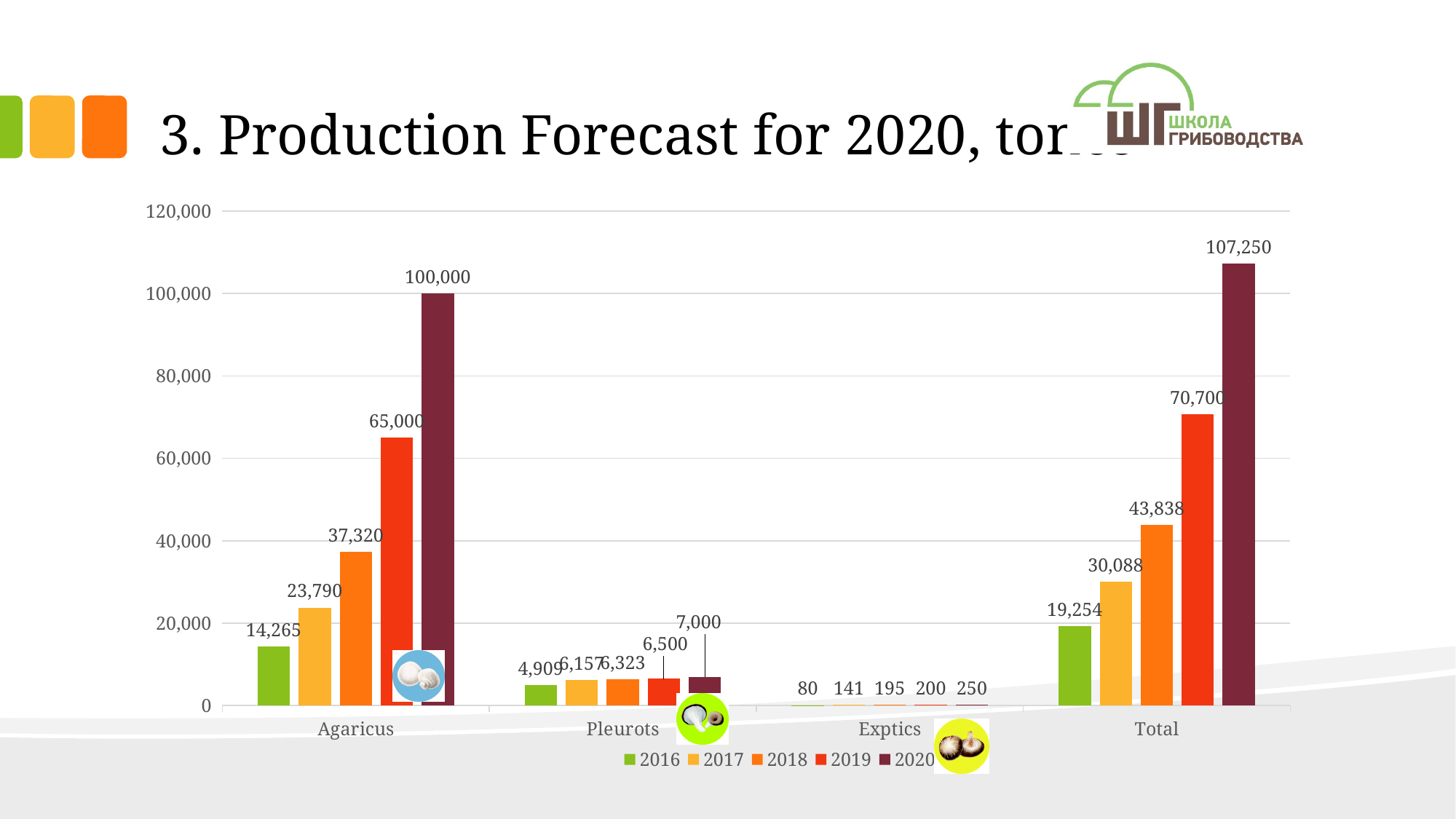
Which category has the highest value in 2018? Total What is the value for Pleurots in 2020? 7,000 Which is larger: the Total value for 2017 or the Agaricus value for 2018? Agaricus value for 2018 What is the difference between the Agaricus values for 2020 and 2019? 35,000 What is the value for Exptics in 2017? 141 What is the Total value for 2019? 70,700 Do the Total values rise or fall from 2016 to 2020? rise Which category has the lowest value in 2016? Exptics What is the value for Agaricus in 2020? 100,000 How many categories are shown on the x axis? 4 How many series does the legend list? 5 Is the Total value for 2020 greater or less than 100,000? greater